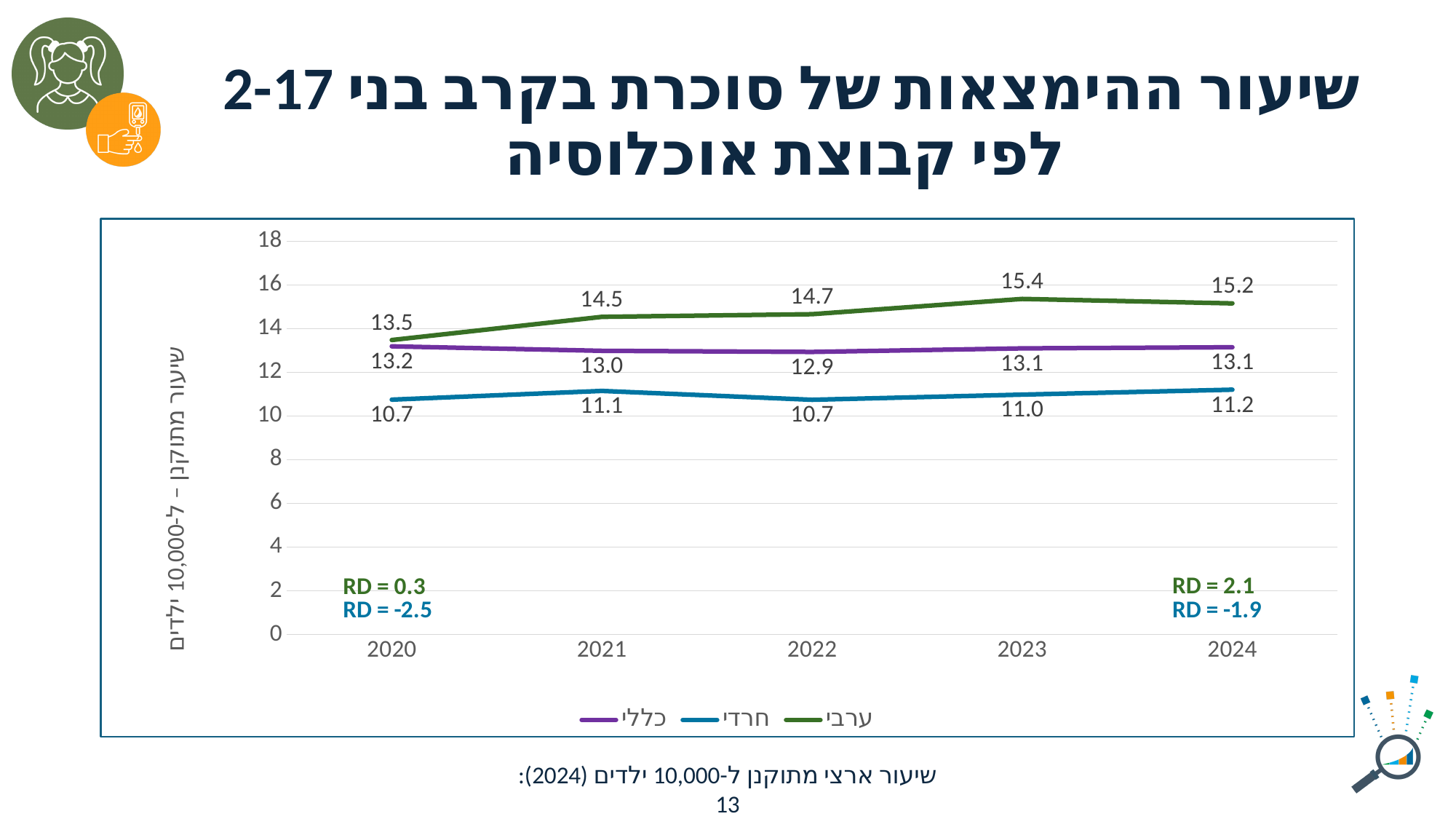
Which series has the larger value in 2021, כללי or חרדי? כללי What is the value for the כללי series in 2022? 12.9 In which year does the ערבי series reach its highest value? 2023 Does the ערבי series generally rise or fall from 2020 to 2023? rise What type of chart is shown on the slide? line chart What is the value for the ערבי series in 2023? 15.4 What is the difference between the ערבי and חרדי values in 2024? 4.0 Which series is drawn in green? ערבי How many series does the legend list? 3 How many years are shown on the x axis? 5 In which year does the כללי series have its lowest value? 2022 What is the value for the חרדי series in 2020? 10.7